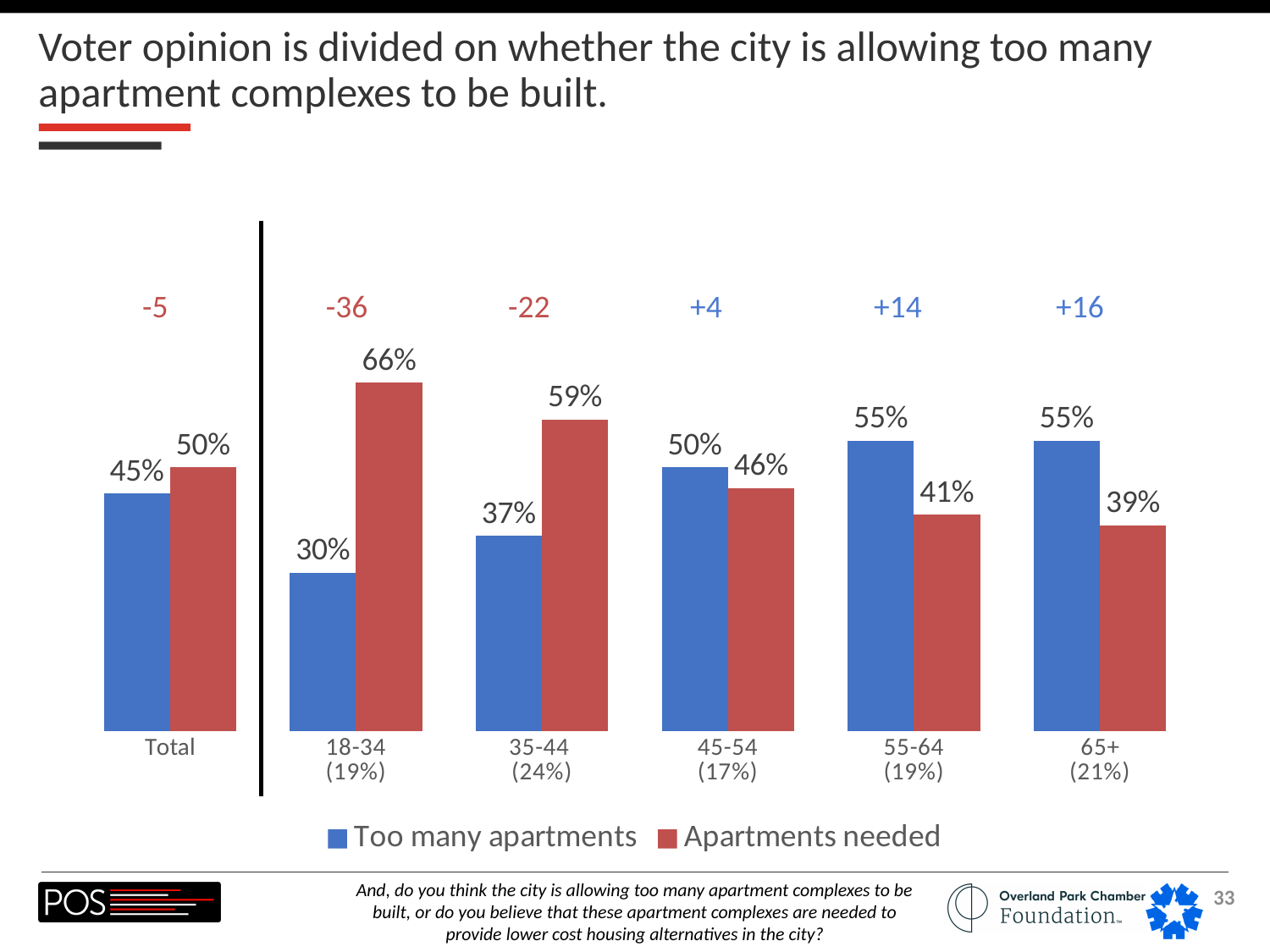
Does the 'Too many apartments' value rise or fall from the 18-34 group to the 55-64 group? Rise How many categories are shown on the x axis? 6 How many series does the legend list? 2 Which age group has the lowest 'Too many apartments' value? 18-34 What kind of chart is shown on the slide? Bar chart What colour represents the 'Apartments needed' series? Red What percentage of voters aged 18-34 say there are too many apartments? 30% What percentage of voters aged 65+ say apartments are needed? 39% Which age group has the highest 'Apartments needed' value? 18-34 What is the difference between the 'Apartments needed' and 'Too many apartments' values for the 35-44 group? 22 percentage points What is the 'Too many apartments' value for the Total category? 45% For the 55-64 group, which is larger: 'Too many apartments' or 'Apartments needed'? Too many apartments